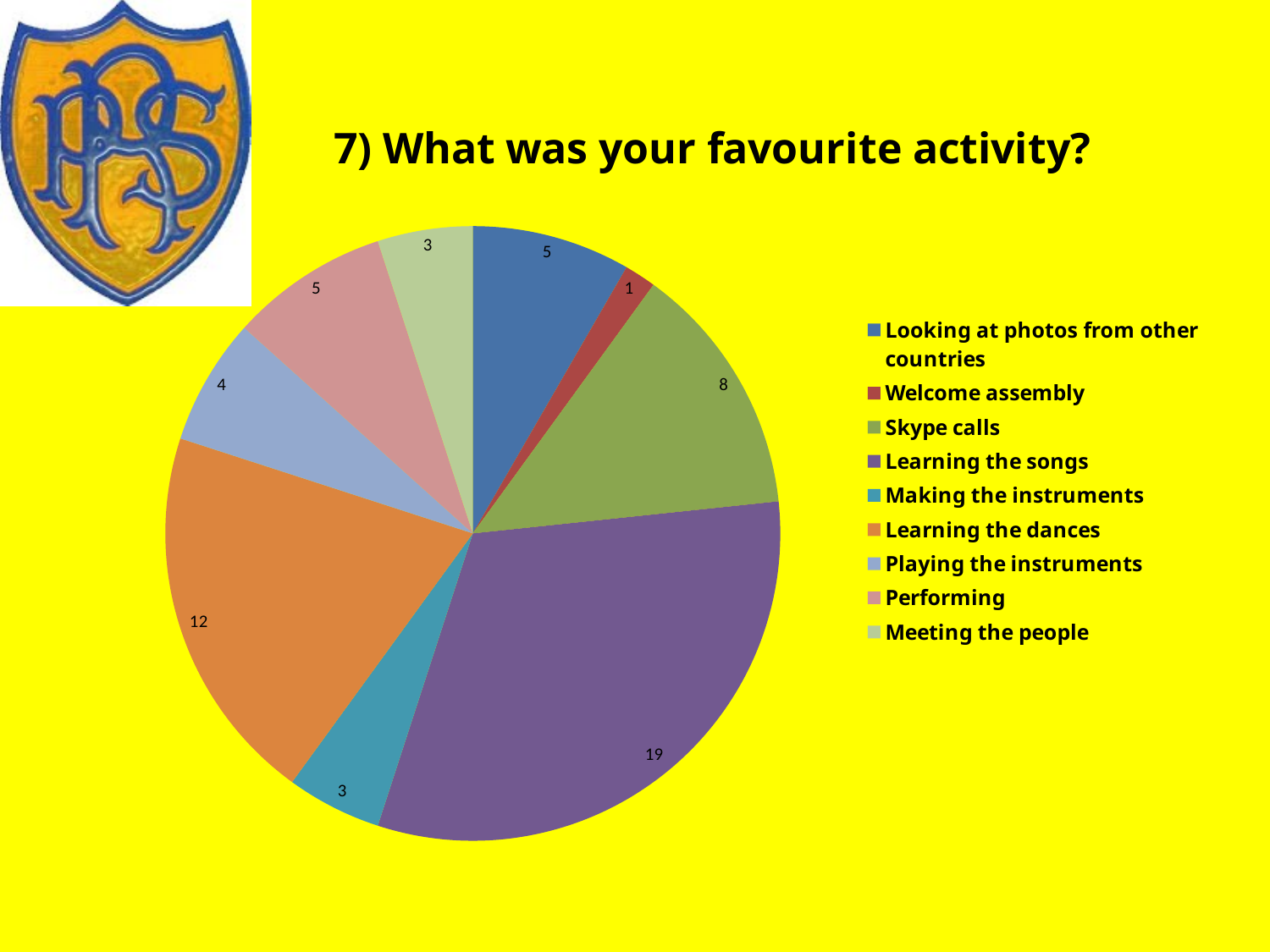
What is the difference between the values for Learning the songs and Learning the dances? 7 Which activity has the largest slice of the pie? Learning the songs What is the value for Learning the dances? 12 What is the value for Skype calls? 8 What share of the pie does Learning the dances represent? 20% What is the value for Welcome assembly? 1 Which is larger, the value for Skype calls or the value for Playing the instruments? Skype calls How many activities are listed in the legend? 9 What kind of chart is shown on the slide? pie chart What is the title of the chart? 7) What was your favourite activity? What is the value for Learning the songs? 19 Which activity has the smallest slice of the pie? Welcome assembly